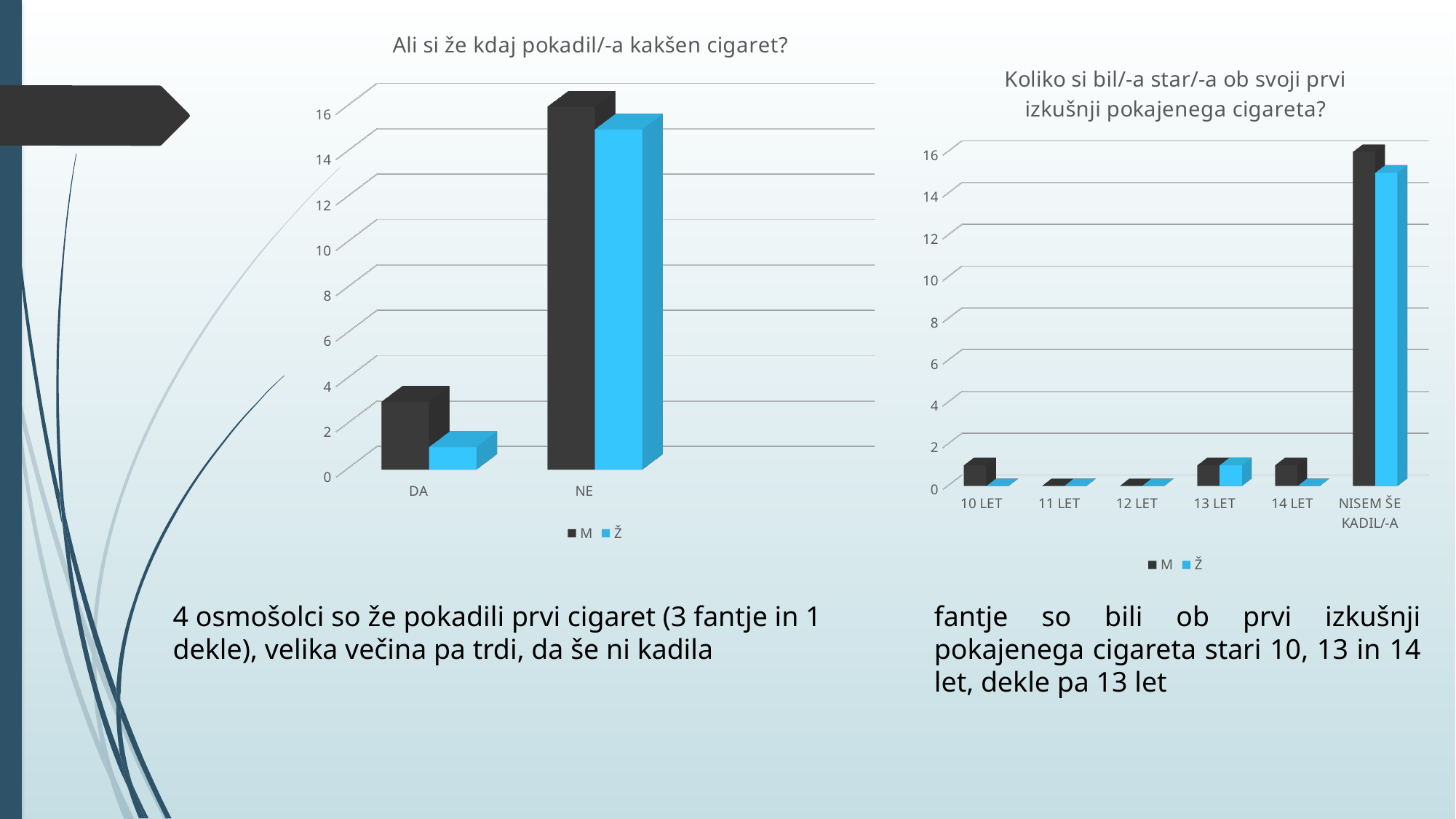
In the left chart "Ali si že kdaj pokadil/-a kakšen cigaret?", which category has the highest Ž value? NE In the left chart "Ali si že kdaj pokadil/-a kakšen cigaret?", how many categories are shown on the x axis? 2 What are the two legend entries of the right chart "Koliko si bil/-a star/-a ob svoji prvi izkušnji pokajenega cigareta?"? M and Ž In the right chart "Koliko si bil/-a star/-a ob svoji prvi izkušnji pokajenega cigareta?", which category has the highest M value? NISEM ŠE KADIL/-A In the left chart "Ali si že kdaj pokadil/-a kakšen cigaret?", which category has the higher M value, DA or NE? NE How many categories are shown on the x axis of the right chart "Koliko si bil/-a star/-a ob svoji prvi izkušnji pokajenega cigareta?"? 6 How many series does the legend of the left chart "Ali si že kdaj pokadil/-a kakšen cigaret?" list? 2 In the left chart "Ali si že kdaj pokadil/-a kakšen cigaret?", is the Ž value for DA greater or less than 2? less What kind of chart is the left chart titled "Ali si že kdaj pokadil/-a kakšen cigaret?"? bar chart In the right chart "Koliko si bil/-a star/-a ob svoji prvi izkušnji pokajenega cigareta?", is the Ž value for NISEM ŠE KADIL/-A greater or less than 14? greater In the left chart "Ali si že kdaj pokadil/-a kakšen cigaret?", is the M value for NE greater or less than 14? greater